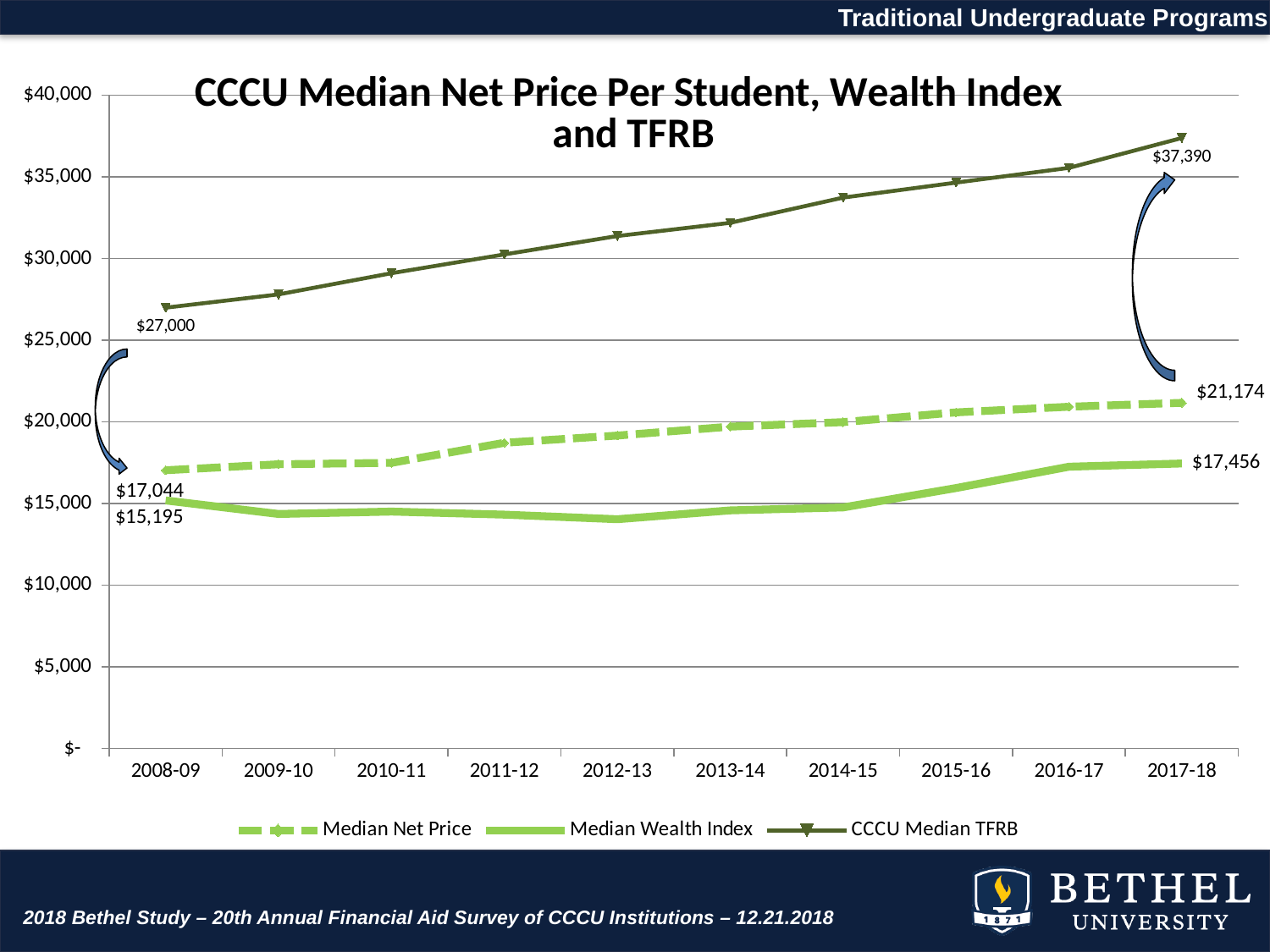
What is the Median Wealth Index for 2008-09? $15,195 What is the difference between the Median Net Price and the Median Wealth Index in 2017-18? $3,718 How many series does the legend list? 3 How many academic years are shown on the x axis? 10 By how much did the CCCU Median TFRB increase from 2008-09 to 2017-18? $10,390 What is the CCCU Median TFRB value for 2008-09? $27,000 What is the title of the chart? CCCU Median Net Price Per Student, Wealth Index and TFRB What kind of chart is shown on the slide? line chart Which series has the highest values across all years? CCCU Median TFRB Is the Median Wealth Index for 2012-13 greater or less than $15,000? less What is the CCCU Median TFRB value for 2017-18? $37,390 What is the Median Net Price for 2017-18? $21,174